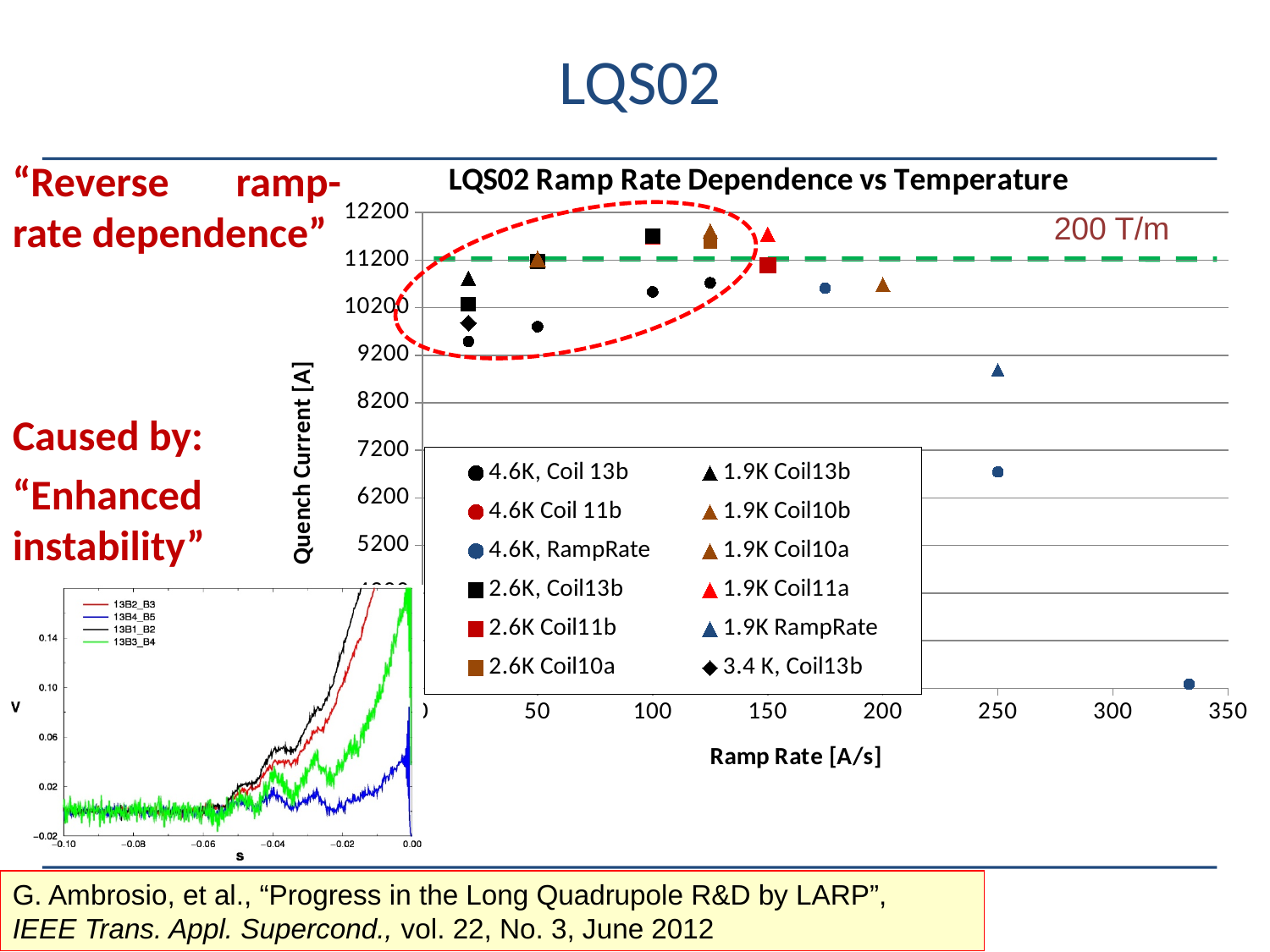
How many series does the legend of the small inset chart in the lower left of the slide list? 4 What is the title of the main chart on the slide? LQS02 Ramp Rate Dependence vs Temperature In the main chart 'LQS02 Ramp Rate Dependence vs Temperature', is the quench current of the 4.6K, RampRate point at 250 A/s greater or less than 7200? less In the main chart 'LQS02 Ramp Rate Dependence vs Temperature', at what quench current is the green dashed line labelled 200 T/m drawn? 11200 In the main chart 'LQS02 Ramp Rate Dependence vs Temperature', does the quench current of the 4.6K, RampRate series rise or fall as the ramp rate increases? fall What kind of chart is the main chart titled 'LQS02 Ramp Rate Dependence vs Temperature'? scatter chart In the main chart 'LQS02 Ramp Rate Dependence vs Temperature', what is the label of the x axis? Ramp Rate [A/s] How many series does the legend of the main chart 'LQS02 Ramp Rate Dependence vs Temperature' list? 12 In the main chart 'LQS02 Ramp Rate Dependence vs Temperature', which series contains the lowest quench current point? 4.6K, RampRate In the main chart 'LQS02 Ramp Rate Dependence vs Temperature', is the quench current of the 1.9K RampRate point at 250 A/s greater or less than 9200? less In the main chart 'LQS02 Ramp Rate Dependence vs Temperature', at a ramp rate of 250 A/s, which has the higher quench current: the 1.9K RampRate point or the 4.6K, RampRate point? 1.9K RampRate In the main chart 'LQS02 Ramp Rate Dependence vs Temperature', is the quench current of the 4.6K, RampRate point at about 333 A/s greater or less than 6200? less